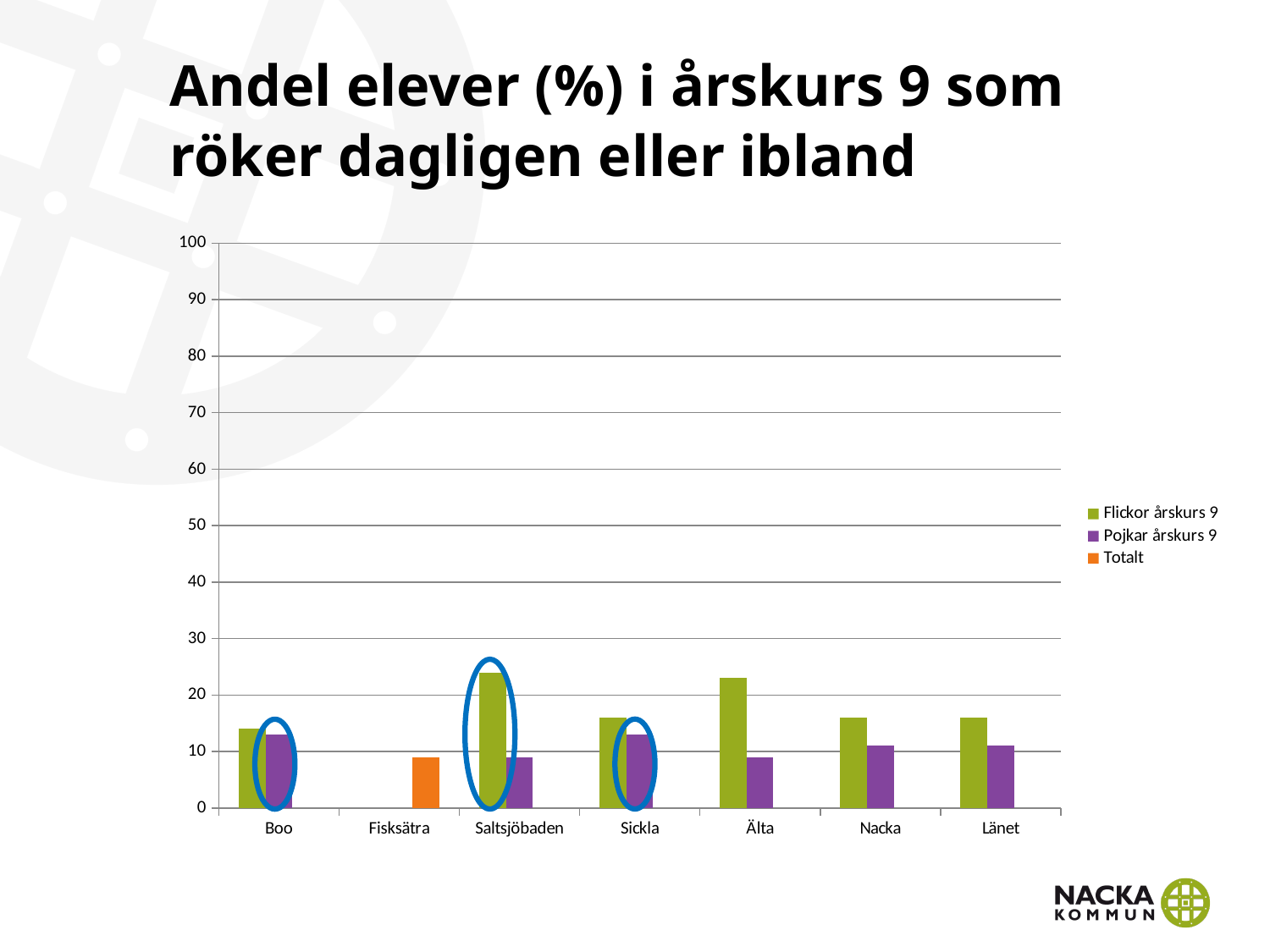
How many categories are shown on the x axis? 7 Is the value for Flickor årskurs 9 in Älta greater or less than 20? greater Is the value for Flickor årskurs 9 in Boo greater or less than 10? greater In Saltsjöbaden, which is larger: Flickor årskurs 9 or Pojkar årskurs 9? Flickor årskurs 9 In Älta, which is larger: Flickor årskurs 9 or Pojkar årskurs 9? Flickor årskurs 9 Is the value for Flickor årskurs 9 in Saltsjöbaden greater or less than 20? greater How many series does the legend list? 3 What colour represents the Totalt series in the legend? orange Which category shows only a Totalt bar and no Flickor or Pojkar bars? Fisksätra What kind of chart is shown on the slide? bar chart